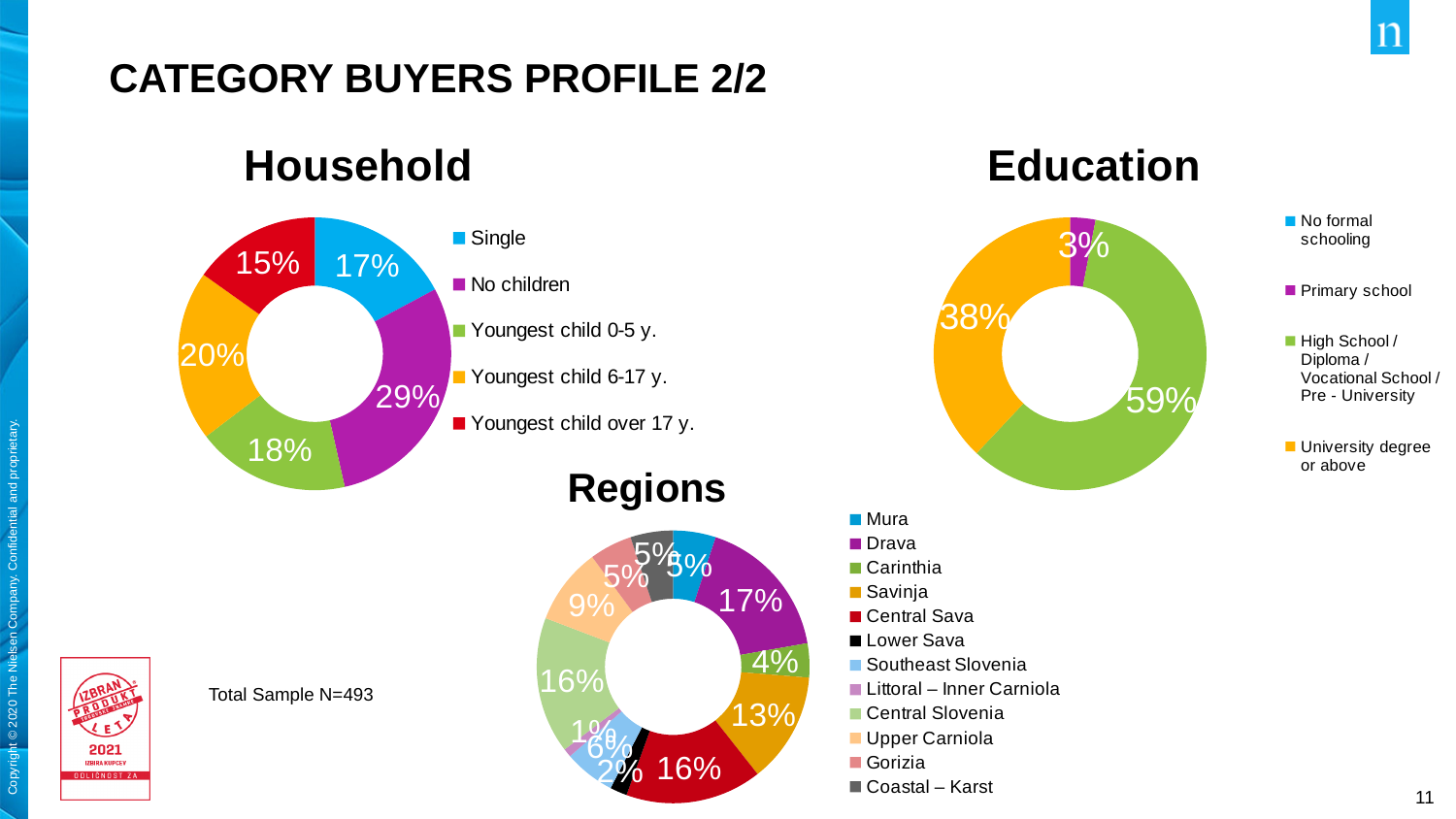
In the Household chart, which household type has the largest share? No children In the Regions chart, which region has the larger share, Drava or Upper Carniola? Drava What type of chart is used for the Household breakdown? Pie chart (donut) In the Household chart, which household type has the smallest share? Youngest child over 17 y. In the Household chart, what percentage of category buyers have no children? 29% In the Household chart, what is the difference between the share for Youngest child 6-17 y. and the share for Single? 3% In the Regions chart, what is the share for Savinja? 13% In the Education chart, what share of buyers have only Primary school education? 3% In the Education chart, what share of buyers have High School / Diploma / Vocational School / Pre - University education? 59% In the Regions chart, what is the share for Drava? 17% How many categories does the legend of the Education chart list? 4 How many regions does the legend of the Regions chart list? 12